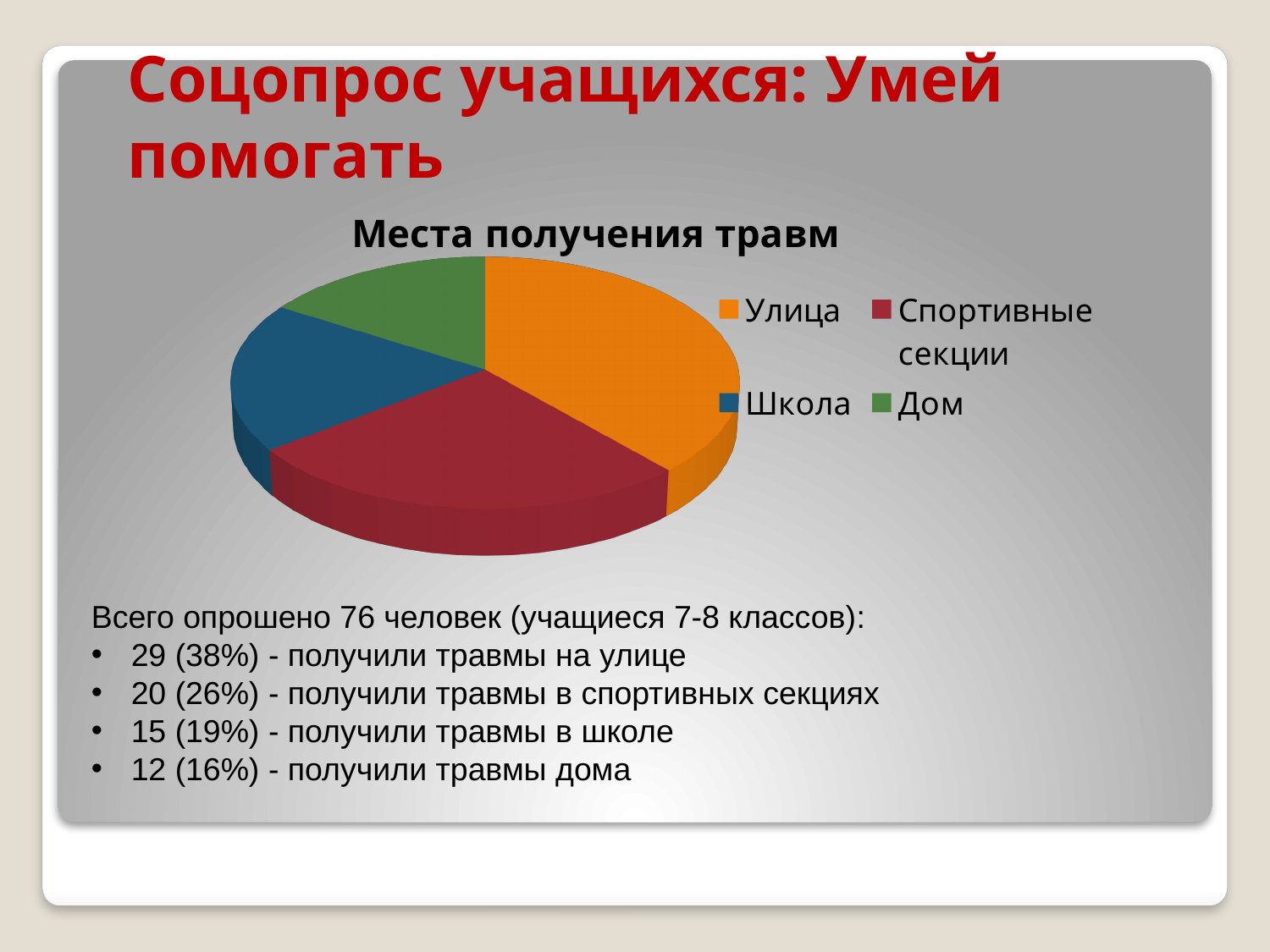
What is the difference between the number of respondents injured on the street (29) and at school (15)? 14 What kind of chart is shown on the slide? pie chart Which category has the largest slice of the pie? Улица According to the slide, what share of respondents were injured in sports sections (Спортивные секции)? 26% What colour is the slice for Школа? blue Which slice is larger, Спортивные секции or Школа? Спортивные секции Which slice is larger, Школа or Дом? Школа According to the slide, what share of respondents were injured at home (Дом)? 16% How many categories does the pie chart have? 4 Which category has the smallest slice of the pie? Дом According to the slide, how many respondents were injured on the street (Улица)? 29 What is the title of the chart? Места получения травм